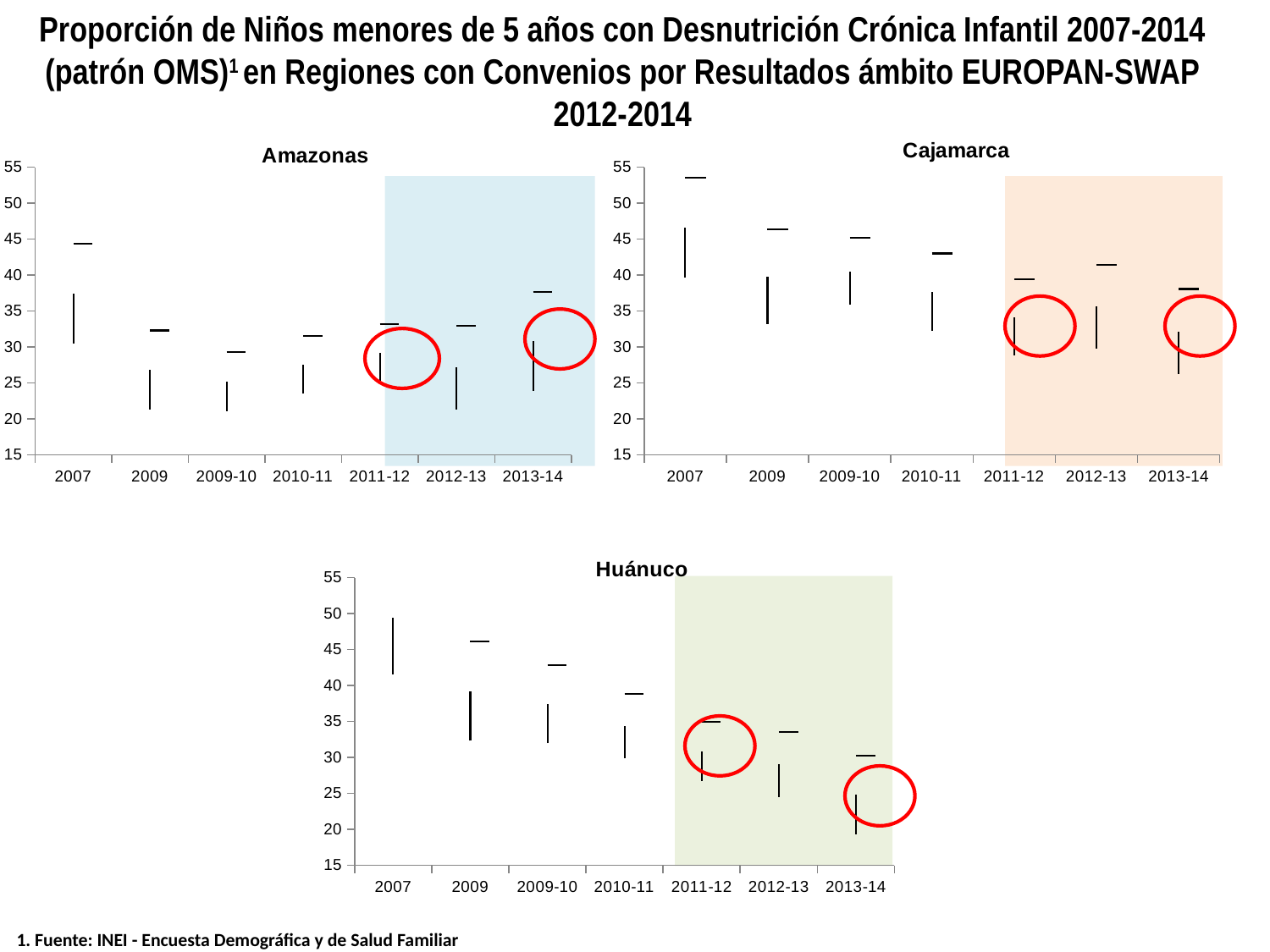
In the Cajamarca chart, do the value markers generally rise or fall from 2007 to 2013-14? fall In the Huánuco chart, which period has the lowest value marker? 2013-14 How many charts are shown on the slide? 3 Which chart has a light blue shaded region over the last three periods? Amazonas In the Huánuco chart, which period has the highest value marker? 2007 In the Cajamarca chart, is the value marker for 2013-14 greater or less than 40? less In the Amazonas chart, how many time periods are shown on the x axis? 7 Which periods are covered by the shaded region in the Huánuco chart? 2011-12, 2012-13 and 2013-14